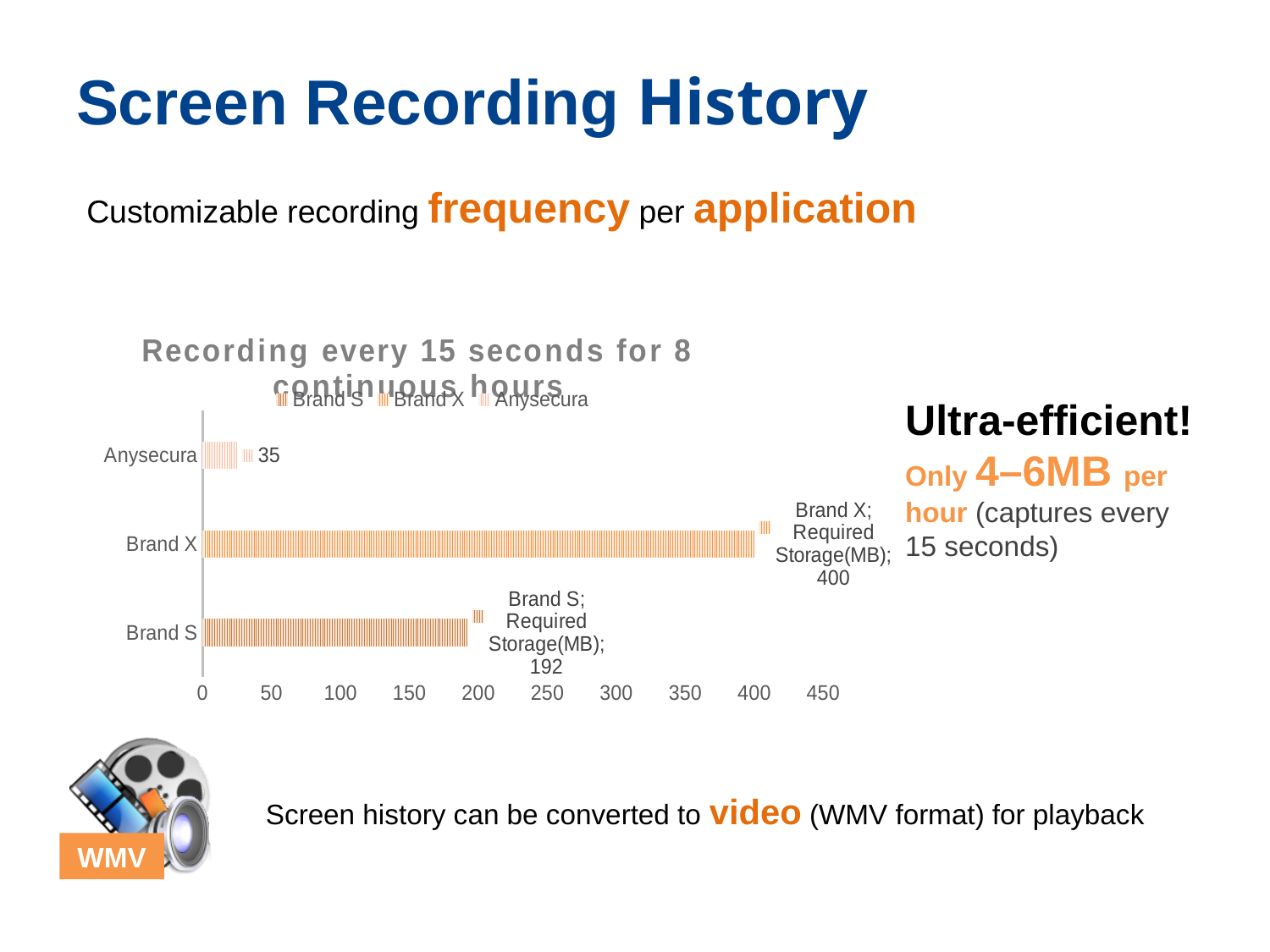
Which is larger, the value for Brand S or the value for Anysecura? Brand S Which category has the lowest required storage? Anysecura What is the difference between the values for Brand X and Brand S? 208 Which category has the highest required storage? Brand X What value is shown for Anysecura? 35 How many categories are shown on the chart? 3 What is the required storage value shown for Brand X? 400 How many entries does the chart legend list? 3 What is the required storage value shown for Brand S? 192 What is the difference between the values for Brand S and Anysecura? 157 Is the value for Brand X greater or less than 350? greater What type of chart is shown on the slide? Bar chart